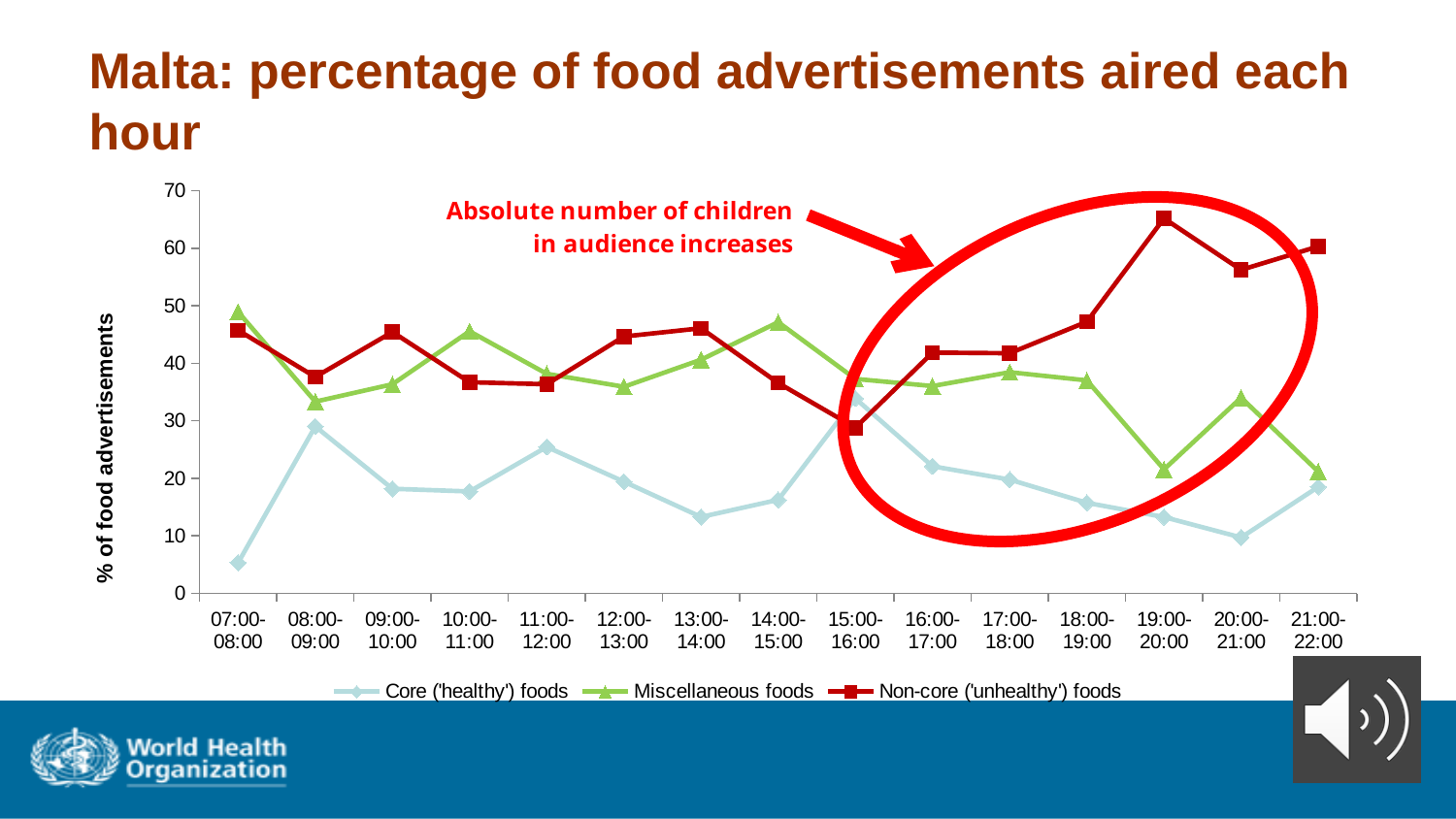
How many series does the legend list? 3 In which hour does the Non-core ('unhealthy') foods series reach its highest value? 19:00-20:00 What is the label on the y axis? % of food advertisements Is the value for Miscellaneous foods at 19:00-20:00 greater or less than 30? less Does the Non-core ('unhealthy') foods series rise or fall from 16:00-17:00 to 19:00-20:00? rise Is the value for Non-core ('unhealthy') foods at 19:00-20:00 greater or less than 60? greater In which hour does the Core ('healthy') foods series have its lowest value? 07:00-08:00 In which hour does the Non-core ('unhealthy') foods series have its lowest value? 15:00-16:00 At 19:00-20:00, which is larger: Non-core ('unhealthy') foods or Core ('healthy') foods? Non-core ('unhealthy') foods How many hourly time slots are shown on the x axis? 15 What kind of chart is shown on the slide? line chart Is the value for Core ('healthy') foods at 07:00-08:00 greater or less than 10? less